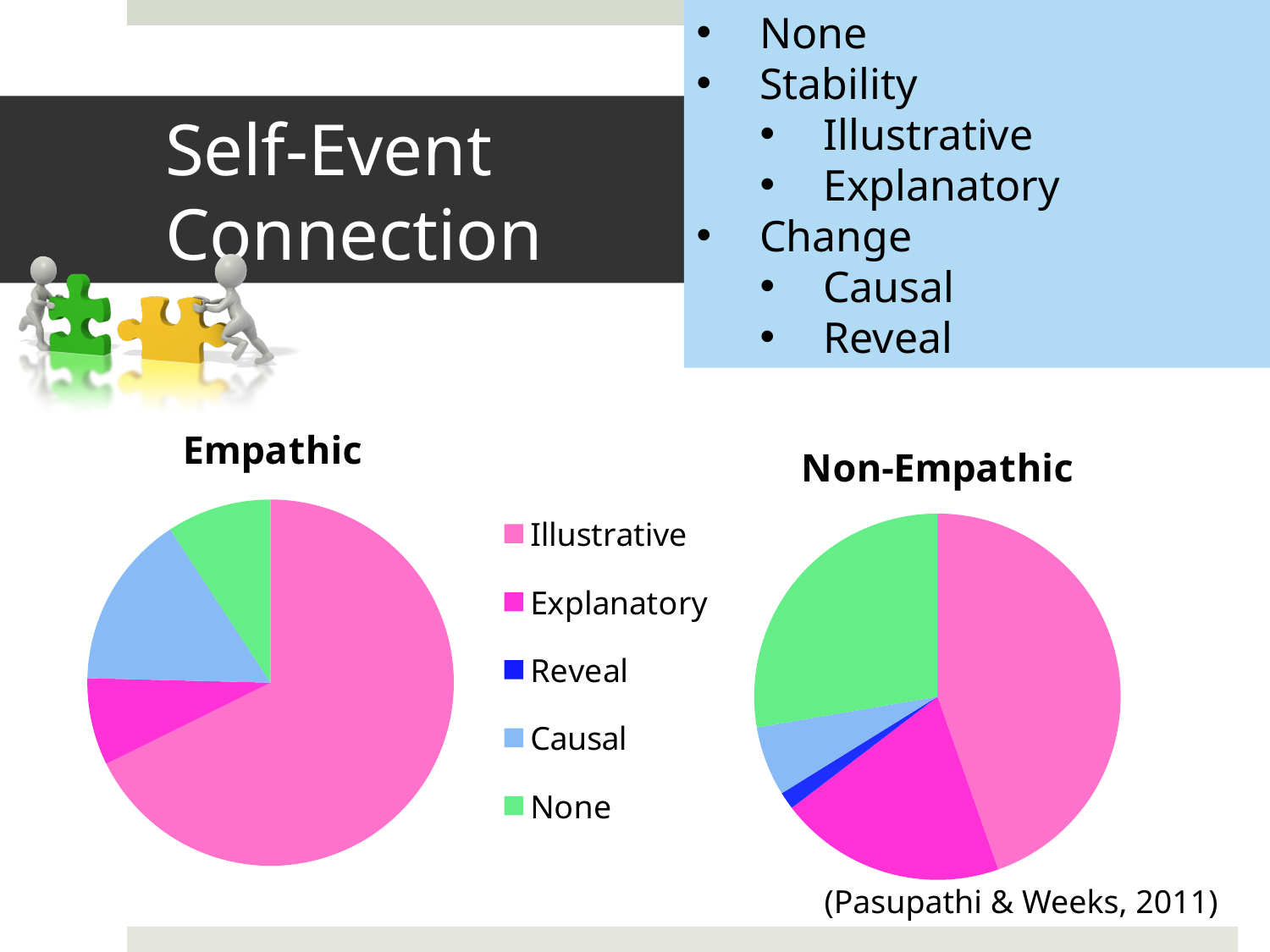
In the Non-Empathic pie chart, which slice is larger, None or Explanatory? None In the Non-Empathic pie chart, which category has the largest slice? Illustrative In the Non-Empathic pie chart, which category has the smallest slice? Reveal What kind of chart is the Empathic chart? pie chart What colour is used for the Illustrative category in the pie charts? pink How many pie charts are shown on the slide? 2 In the Non-Empathic pie chart, which slice is larger, Causal or Reveal? Causal How many categories does the legend shared by the two pie charts list? 5 In the Empathic pie chart, which category has the largest slice? Illustrative In the Empathic pie chart, which slice is larger, Illustrative or Causal? Illustrative What kind of chart is the Non-Empathic chart? pie chart